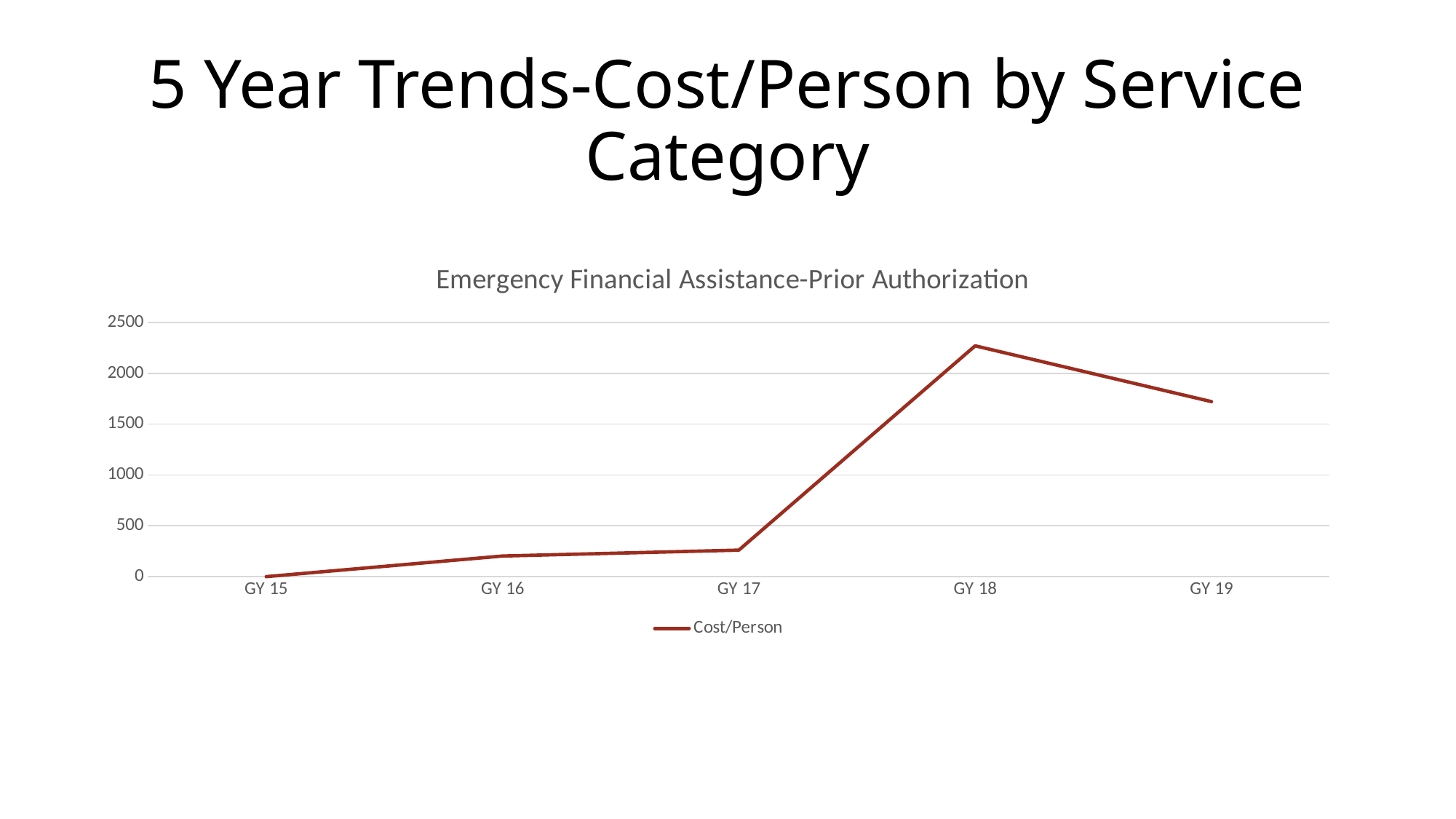
Which has a higher Cost/Person, GY 18 or GY 19? GY 18 Is the Cost/Person for GY 19 greater or less than 1500? greater Which grant year has the highest Cost/Person? GY 18 How many grant years are plotted on the x axis? 5 What is the title of the chart? Emergency Financial Assistance-Prior Authorization How many series does the legend list? 1 Does the Cost/Person rise or fall from GY 18 to GY 19? fall Is the Cost/Person for GY 18 greater or less than 2000? greater What kind of chart is shown on the slide? line chart What is the name of the series shown in the legend? Cost/Person Is the Cost/Person for GY 17 greater or less than 500? less Which grant year has the lowest Cost/Person? GY 15